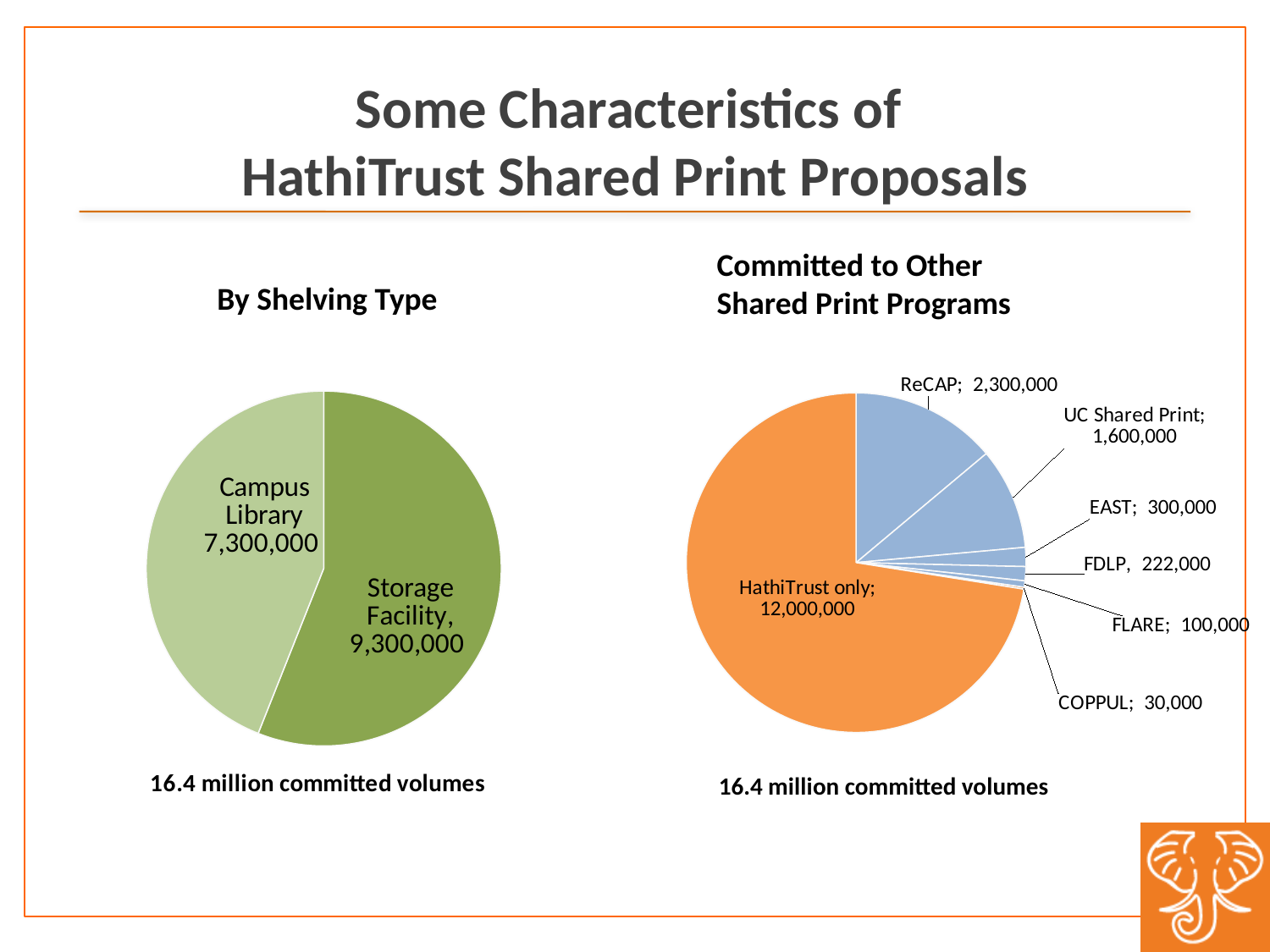
In the 'By Shelving Type' pie chart, what is the difference between Storage Facility and Campus Library? 2,000,000 In the 'By Shelving Type' pie chart, how many slices are there? 2 In the 'Committed to Other Shared Print Programs' chart, what is the value for FDLP? 222,000 In the 'By Shelving Type' pie chart, what is the value for Campus Library? 7,300,000 In the 'Committed to Other Shared Print Programs' chart, how many categories are shown? 7 In the 'By Shelving Type' pie chart, which slice is larger, Campus Library or Storage Facility? Storage Facility In the 'By Shelving Type' pie chart, what is the value for Storage Facility? 9,300,000 In the 'Committed to Other Shared Print Programs' chart, what is the difference between ReCAP and UC Shared Print? 700,000 What type of chart is used for 'Committed to Other Shared Print Programs'? Pie chart In the 'Committed to Other Shared Print Programs' chart, which category has the largest value? HathiTrust only In the 'Committed to Other Shared Print Programs' chart, what is the value for ReCAP? 2,300,000 In the 'Committed to Other Shared Print Programs' chart, which category has the smallest value? COPPUL